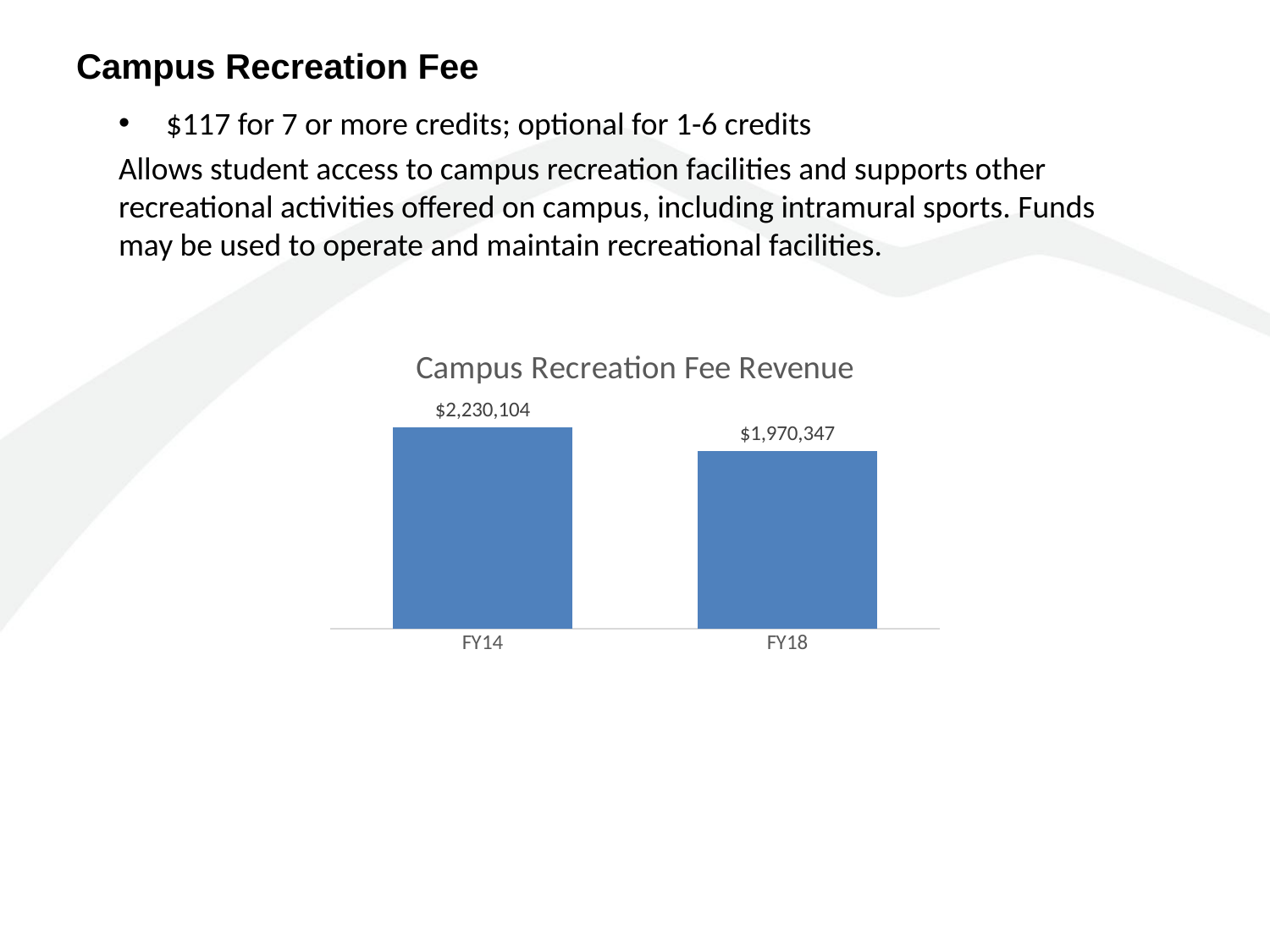
What kind of chart is used to show Campus Recreation Fee Revenue? Bar chart Which fiscal year has the highest Campus Recreation Fee Revenue? FY14 What colour are the bars in the Campus Recreation Fee Revenue chart? Blue Which fiscal year has the lowest Campus Recreation Fee Revenue? FY18 What is the Campus Recreation Fee Revenue for FY18? $1,970,347 How many fiscal years are shown in the Campus Recreation Fee Revenue chart? 2 What is the difference between the FY14 and FY18 Campus Recreation Fee Revenue? $259,757 What is the title of the chart on the slide? Campus Recreation Fee Revenue What is the Campus Recreation Fee Revenue for FY14? $2,230,104 Does the Campus Recreation Fee Revenue rise or fall from FY14 to FY18? Fall Is the Campus Recreation Fee Revenue larger in FY14 or FY18? FY14